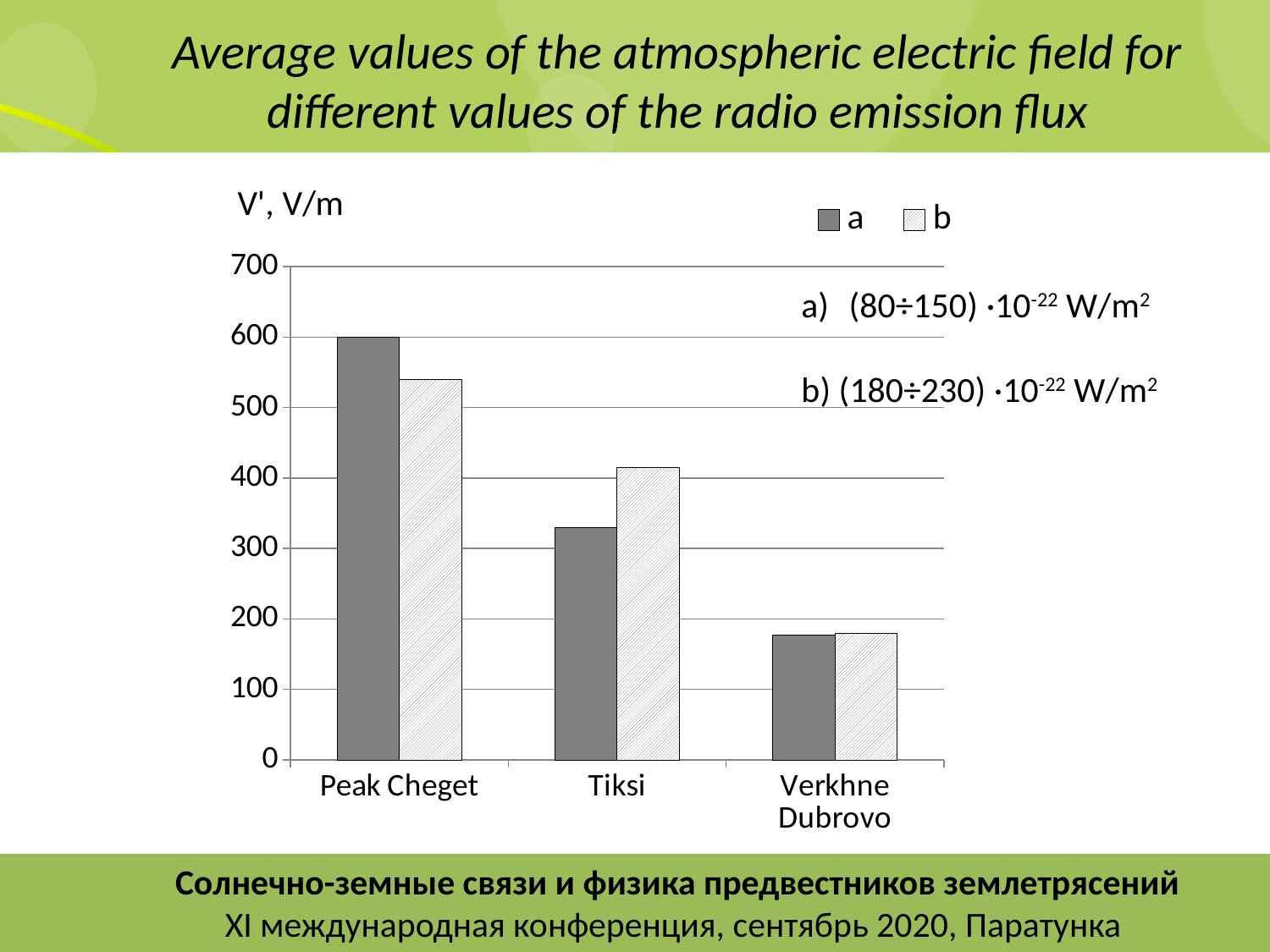
For Peak Cheget, which series has the larger value, a or b? a For Tiksi, which series has the larger value, a or b? b What is the label on the vertical axis of the chart? V', V/m Which category has the lowest value for series b? Verkhne Dubrovo What kind of chart is shown on the slide? bar chart Is the value for series a at Verkhne Dubrovo greater or less than 200? less Is the value for series b at Peak Cheget greater or less than 500? greater Which category has the highest value for series a? Peak Cheget How many categories (stations) are shown on the x axis? 3 How many series does the legend list? 2 Do the values for series a rise or fall from left to right along the x axis? fall Is the value for series b at Tiksi greater or less than 400? greater